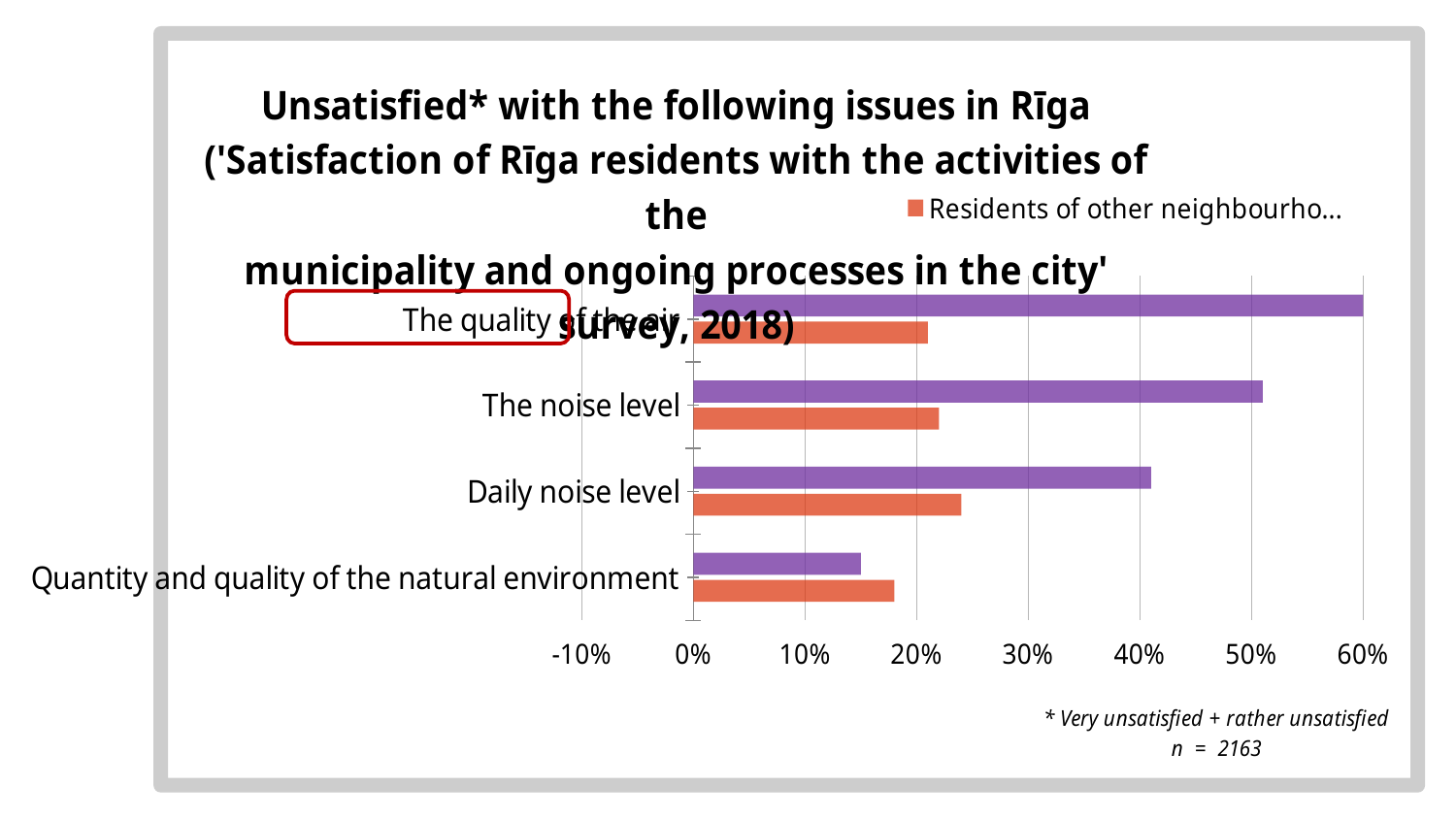
For Quantity and quality of the natural environment, which bar is longer, the purple one or the orange one? the orange one What sample size (n) is given in the footnote below the chart? n = 2163 Is the orange bar for The quality of the air greater or less than 30%? less Which category has the longest purple bar? The quality of the air Is the purple bar for Quantity and quality of the natural environment greater or less than 20%? less Is the orange bar for Daily noise level greater or less than 20%? greater For The quality of the air, which bar is longer, the purple one or the orange one? the purple one What kind of chart is shown on the slide? bar chart Which category has the shortest purple bar? Quantity and quality of the natural environment How many categories (issues) are listed on the chart? 4